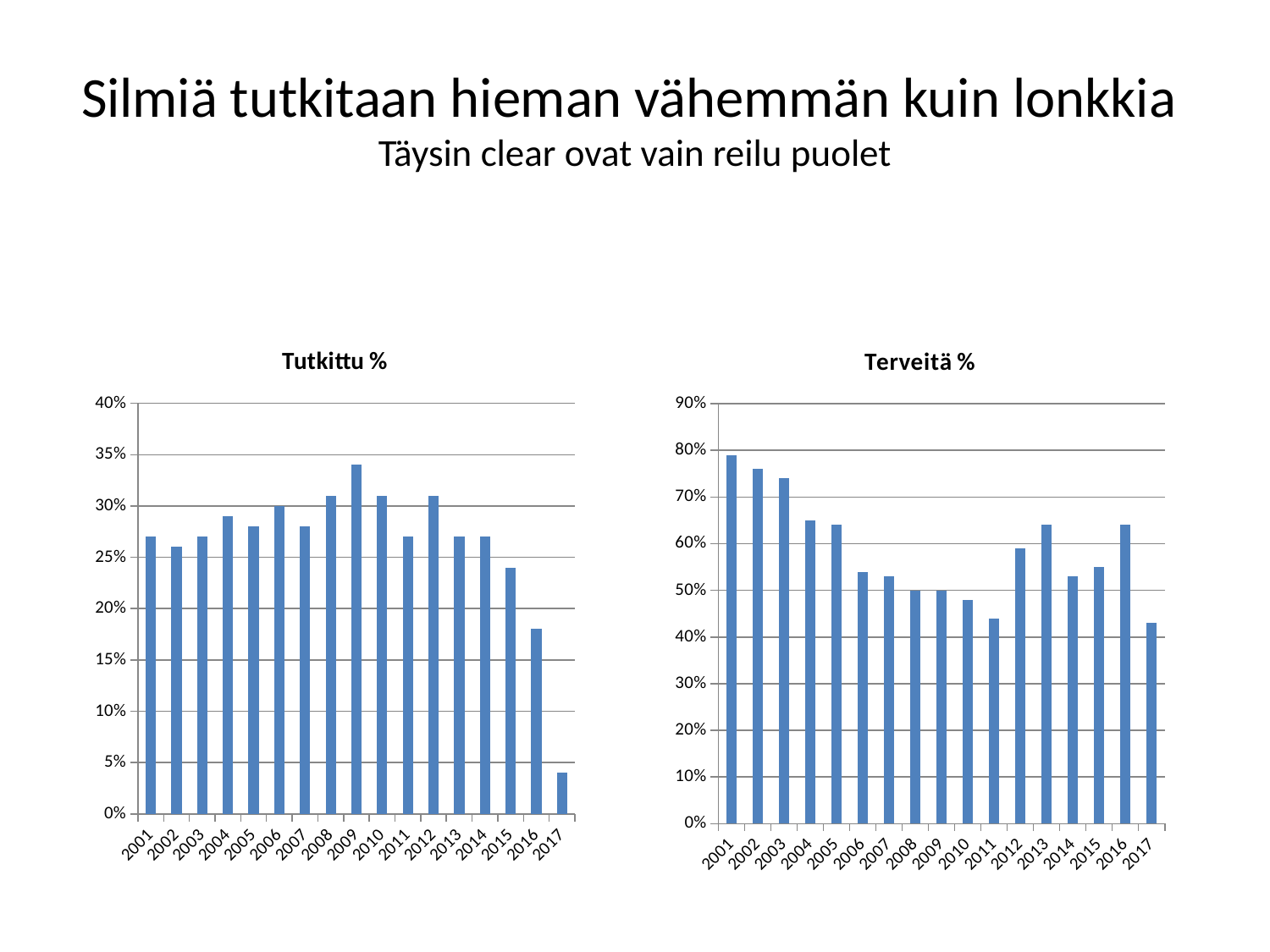
In the "Terveitä %" chart, which year has the lowest value? 2017 In the "Tutkittu %" chart, which year has the lowest value? 2017 In the "Tutkittu %" chart, is the value for 2009 greater or less than 30%? greater In the "Tutkittu %" chart, do the values rise or fall from 2014 to 2017? fall How many years are shown on the x axis of the "Terveitä %" chart? 17 What kind of chart is the "Tutkittu %" chart on the left? bar chart In the "Terveitä %" chart, is the value for 2011 greater or less than 50%? less In the "Terveitä %" chart, is the value for 2002 greater or less than 70%? greater In the "Terveitä %" chart, which year has the highest value? 2001 In the "Terveitä %" chart, which year has the larger value, 2003 or 2006? 2003 In the "Tutkittu %" chart, which year has the highest value? 2009